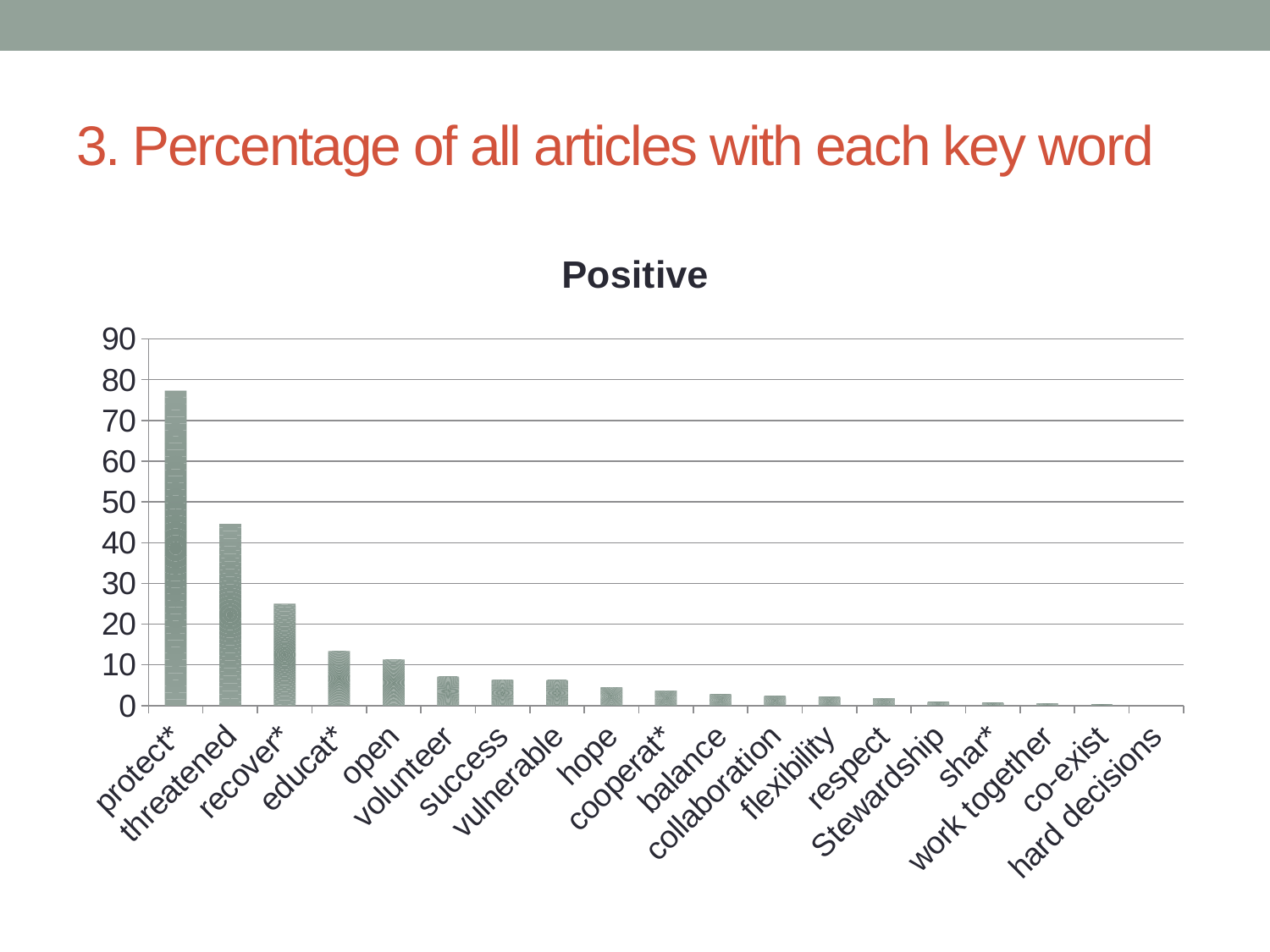
Is the value for threatened greater or less than 40? greater Is the value for recover* greater or less than 30? less Which has a higher value, threatened or recover*? threatened Which key word has the highest percentage of articles? protect* What kind of chart is shown on the slide? bar chart Is the value for threatened greater or less than 50? less Do the values rise or fall moving from left to right along the x axis? fall How many key words (categories) are plotted on the chart? 19 What is the title of the chart? Positive